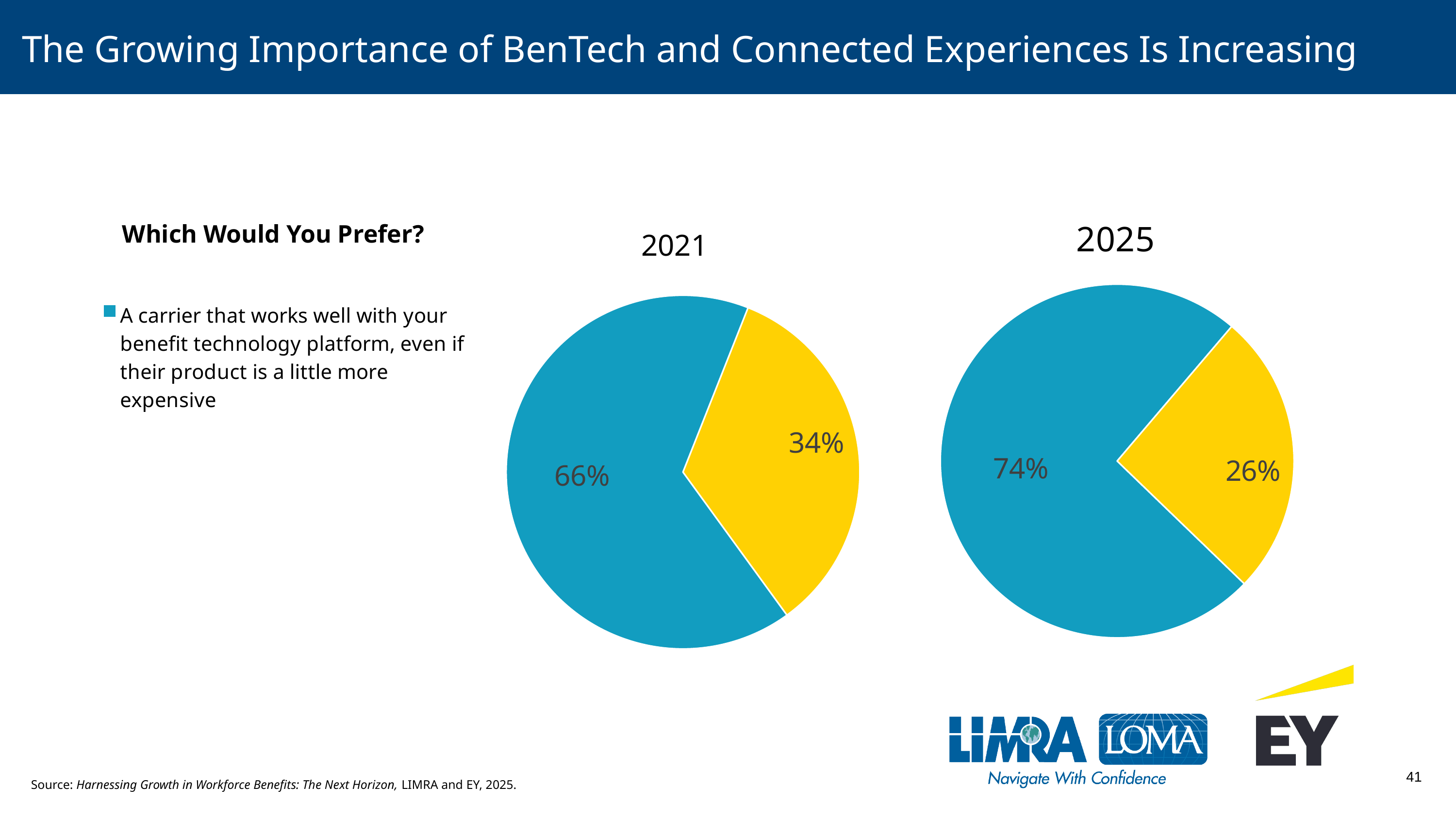
Did the share preferring a carrier that works well with their benefit technology platform rise or fall from 2021 to 2025? rise In the 2025 pie chart, which slice is the smallest? the yellow slice (26%) In the 2021 pie chart, which slice is larger, the blue slice or the yellow slice? the blue slice In the 2025 pie chart, what share is shown for the blue slice (a carrier that works well with your benefit technology platform, even if their product is a little more expensive)? 74% What is the difference between the blue slice's share in the 2025 pie chart and the blue slice's share in the 2021 pie chart? 8 percentage points In the 2021 pie chart, what is the difference between the blue slice and the yellow slice? 32 percentage points In the 2025 pie chart, what share is shown for the yellow slice? 26% In the 2021 pie chart, what share is shown for the blue slice (a carrier that works well with your benefit technology platform, even if their product is a little more expensive)? 66% What type of chart is used for the 2021 and 2025 data on this slide? pie chart In the 2021 pie chart, what share is shown for the yellow slice? 34% How many slices does the 2025 pie chart have? 2 What question is the legend on the left of the slide answering? Which Would You Prefer?